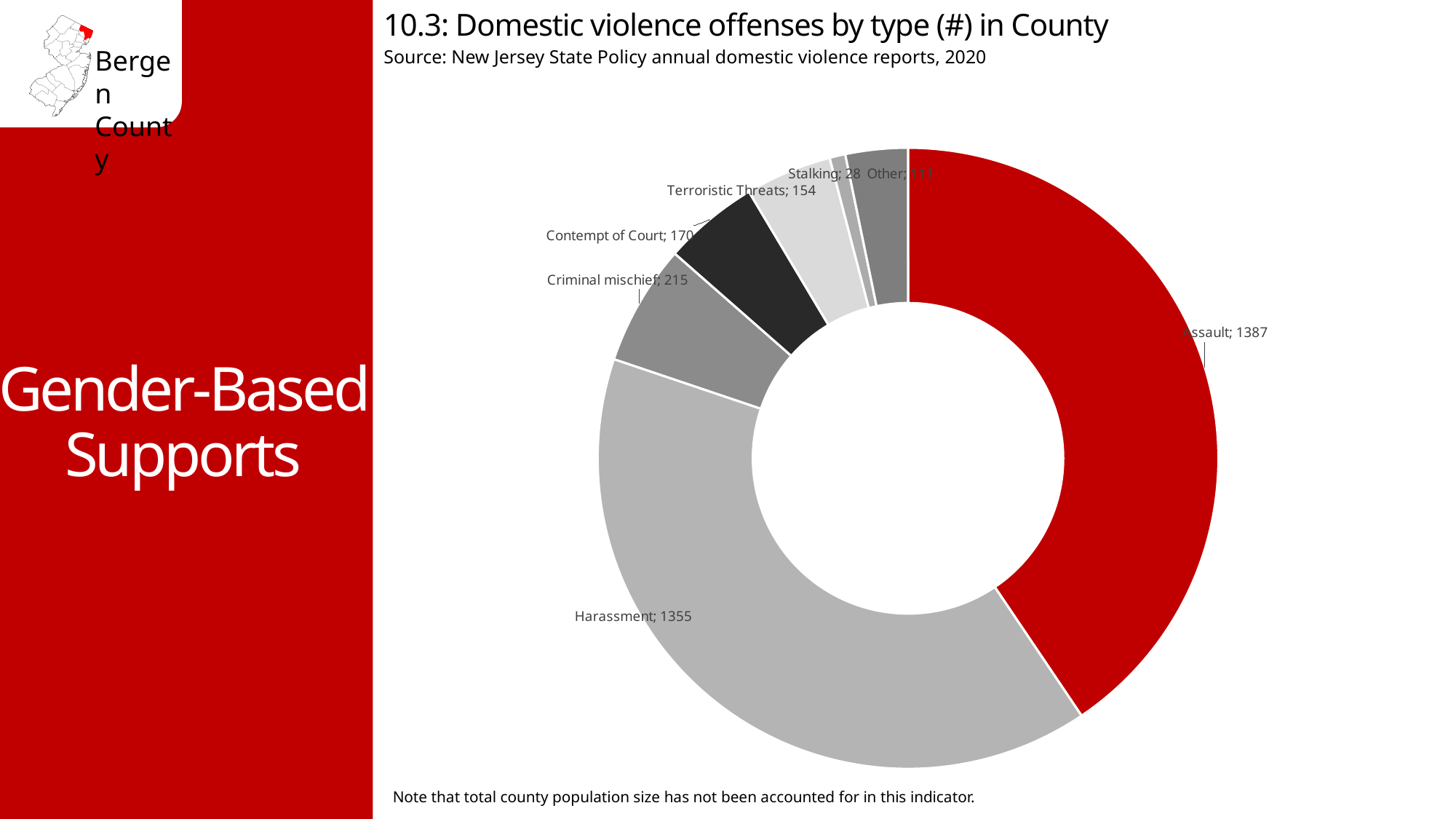
What is the value for Harassment on the chart? 1355 How many domestic violence offenses of type Assault are shown on the chart? 1387 How many offense types are shown on the chart? 7 What is the value for Terroristic Threats? 154 Which offense type has the smallest slice on the chart? Stalking What is the value for Contempt of Court? 170 What kind of chart is shown on the slide? Pie chart (doughnut) What is the value for Stalking? 28 What is the value for Criminal mischief? 215 Which is larger, the value for Criminal mischief or the value for Contempt of Court? Criminal mischief Which offense type has the largest slice on the chart? Assault What is the difference between the Assault and Harassment values? 32